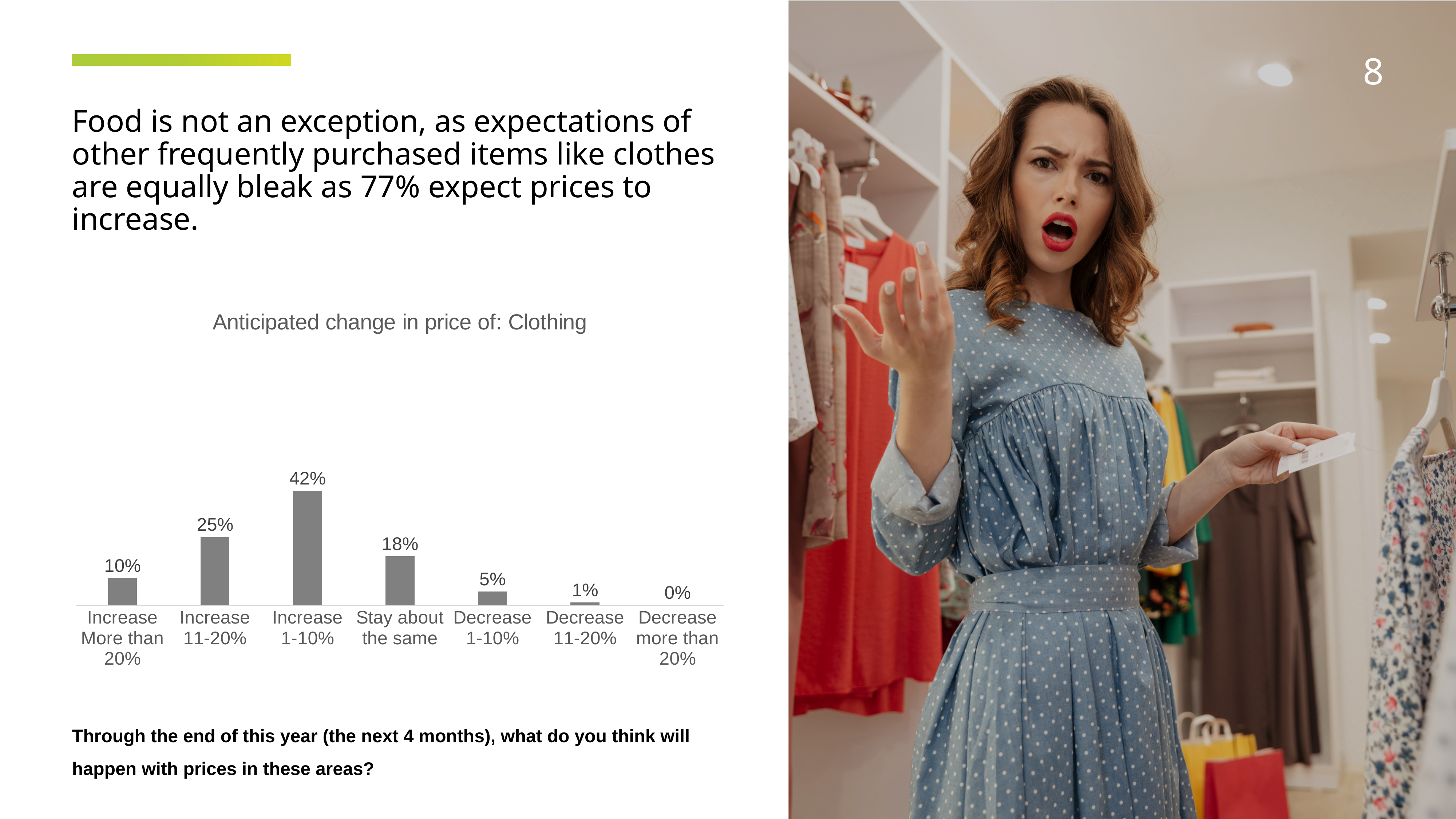
What is the title of the chart? Anticipated change in price of: Clothing What is the difference between 'Stay about the same' and 'Decrease 1-10%'? 13% What percentage of respondents expect clothing prices to increase by 1-10%? 42% What is the difference between the values for 'Increase 1-10%' and 'Increase 11-20%'? 17% What percentage expect clothing prices to decrease by 11-20%? 1% What kind of chart is shown on the slide? Bar chart Which is larger: the value for 'Increase More than 20%' or 'Decrease 1-10%'? Increase More than 20% How many categories are shown in the chart? 7 What is the value for 'Stay about the same' in the clothing price chart? 18% Which category has the lowest value in the chart? Decrease more than 20% What is the combined value of the three 'Increase' categories? 77% Which category has the highest value in the chart? Increase 1-10%